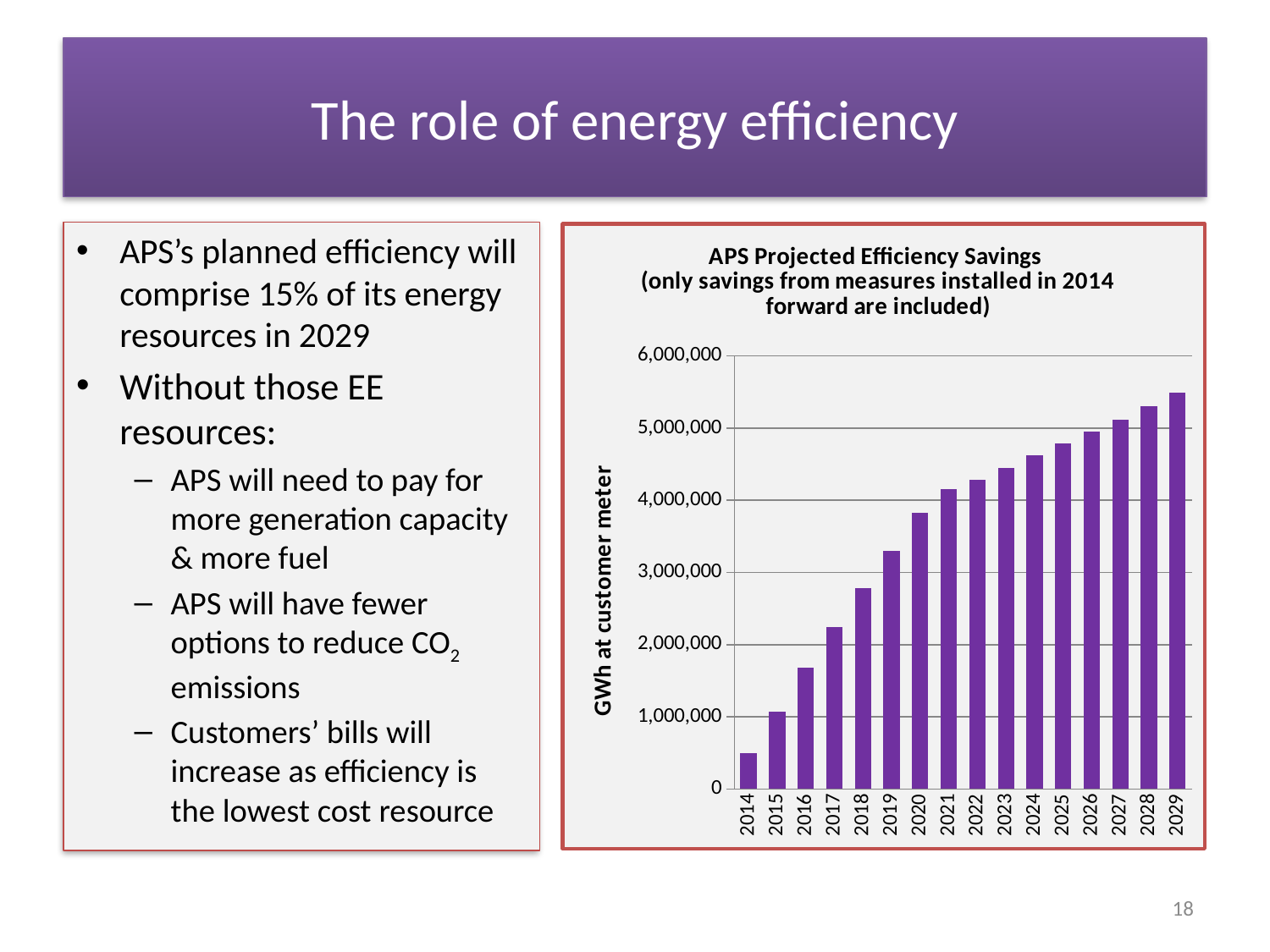
Which year has the lowest projected efficiency savings? 2014 Do the projected efficiency savings rise or fall from 2014 to 2029? Rise How many years are plotted on the x axis of the chart? 16 What kind of chart is shown on the slide? Bar chart Is the value for 2029 greater or less than 5,000,000? greater Is the value for 2020 greater or less than 4,000,000? less What is the first line of the chart's title? APS Projected Efficiency Savings What is the label on the vertical axis of the chart? GWh at customer meter Is the value for 2019 greater or less than 3,000,000? greater Which year has the highest projected efficiency savings? 2029 Which year has the larger projected efficiency savings, 2016 or 2020? 2020